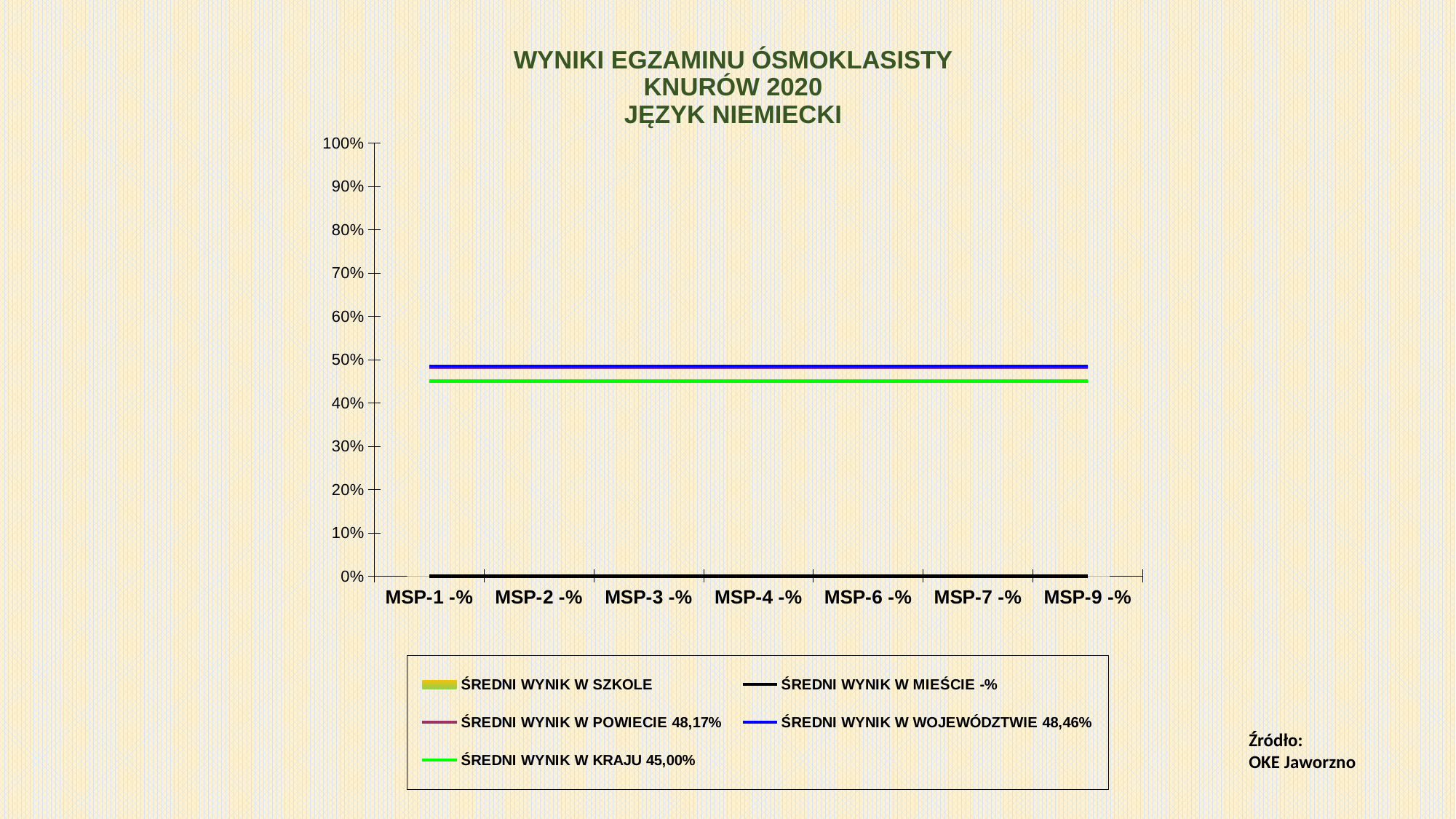
How many series does the legend list? 5 Which is larger, the voivodeship average (48,46%) or the national average (45,00%)? ŚREDNI WYNIK W WOJEWÓDZTWIE (48,46%) What is the average result in the voivodeship (ŚREDNI WYNIK W WOJEWÓDZTWIE) shown in the legend? 48,46% Is the national average line (ŚREDNI WYNIK W KRAJU) greater or less than 50%? less Do the plotted lines rise, fall or stay flat across the x axis? stay flat What colour is the line for ŚREDNI WYNIK W WOJEWÓDZTWIE? blue What subject does the chart title say the exam results are for? JĘZYK NIEMIECKI How many school categories are shown on the x axis? 7 What is the national average result (ŚREDNI WYNIK W KRAJU) shown in the legend? 45,00% What is the difference between the voivodeship average (48,46%) and the national average (45,00%)? 3,46% Of the powiat, voivodeship and national averages, which is the lowest? ŚREDNI WYNIK W KRAJU (45,00%) What is the average result in the powiat (ŚREDNI WYNIK W POWIECIE) shown in the legend? 48,17%